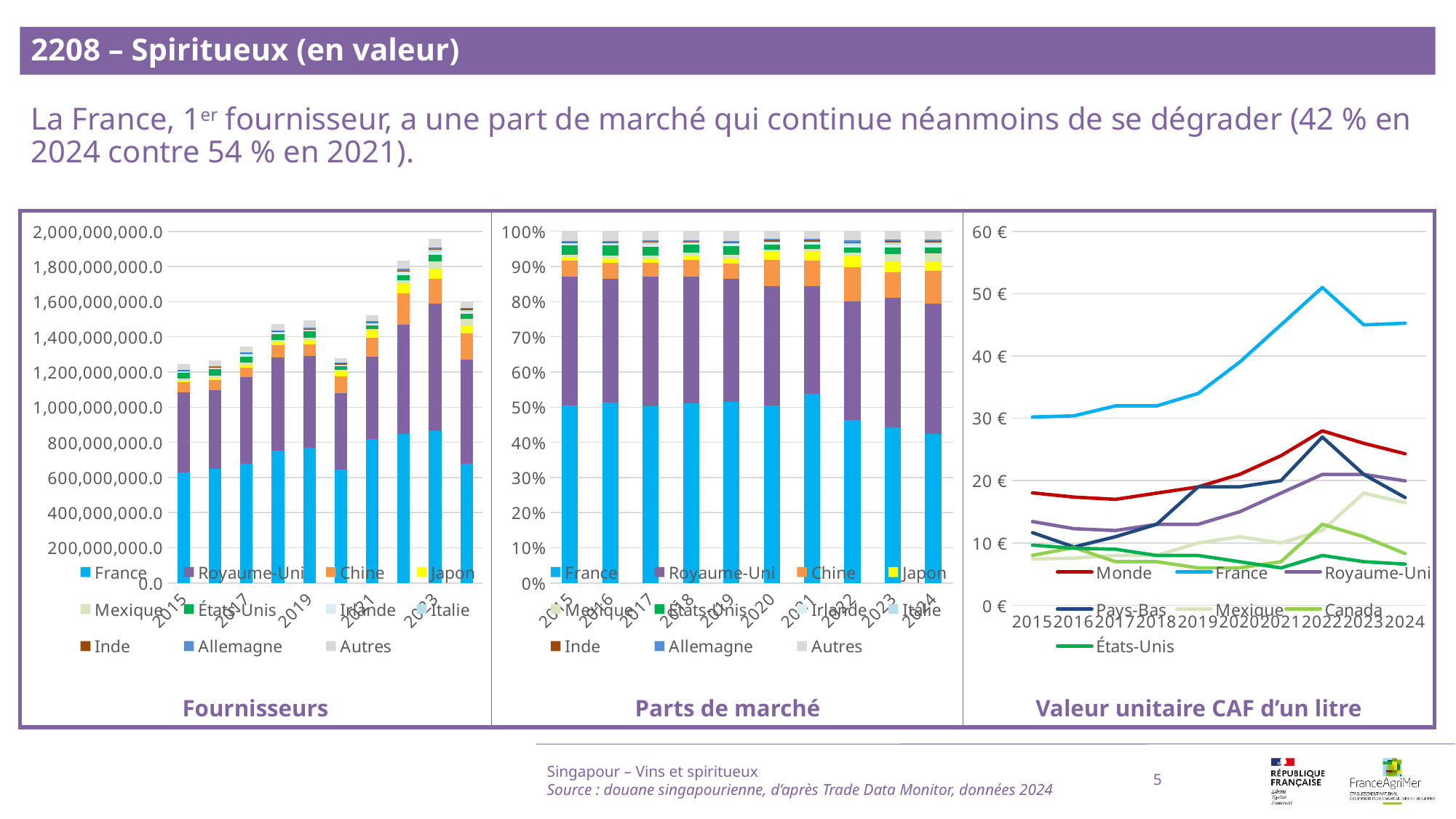
What kind of chart is the 'Valeur unitaire CAF d'un litre' chart? line chart In the 'Fournisseurs' chart, which total bar is larger, 2023 or 2024? 2023 In the 'Fournisseurs' chart, is the France value for 2024 greater or less than 800,000,000.0? less How many series does the legend of the 'Parts de marché' chart list? 11 In the 'Parts de marché' chart, does the France share rise or fall from 2021 to 2024? fall In the 'Fournisseurs' chart, is the total bar for 2023 greater or less than 1,800,000,000.0? greater In the 'Valeur unitaire CAF d'un litre' chart, is the France value for 2022 greater or less than 40 €? greater In the 'Fournisseurs' chart, which year has the highest total bar? 2023 In the 'Valeur unitaire CAF d'un litre' chart, which series has the highest value in 2024? France How many series does the legend of the 'Valeur unitaire CAF d'un litre' chart list? 7 In the 'Fournisseurs' chart, how many years are shown on the x axis? 10 What kind of chart is the 'Fournisseurs' chart? stacked bar chart